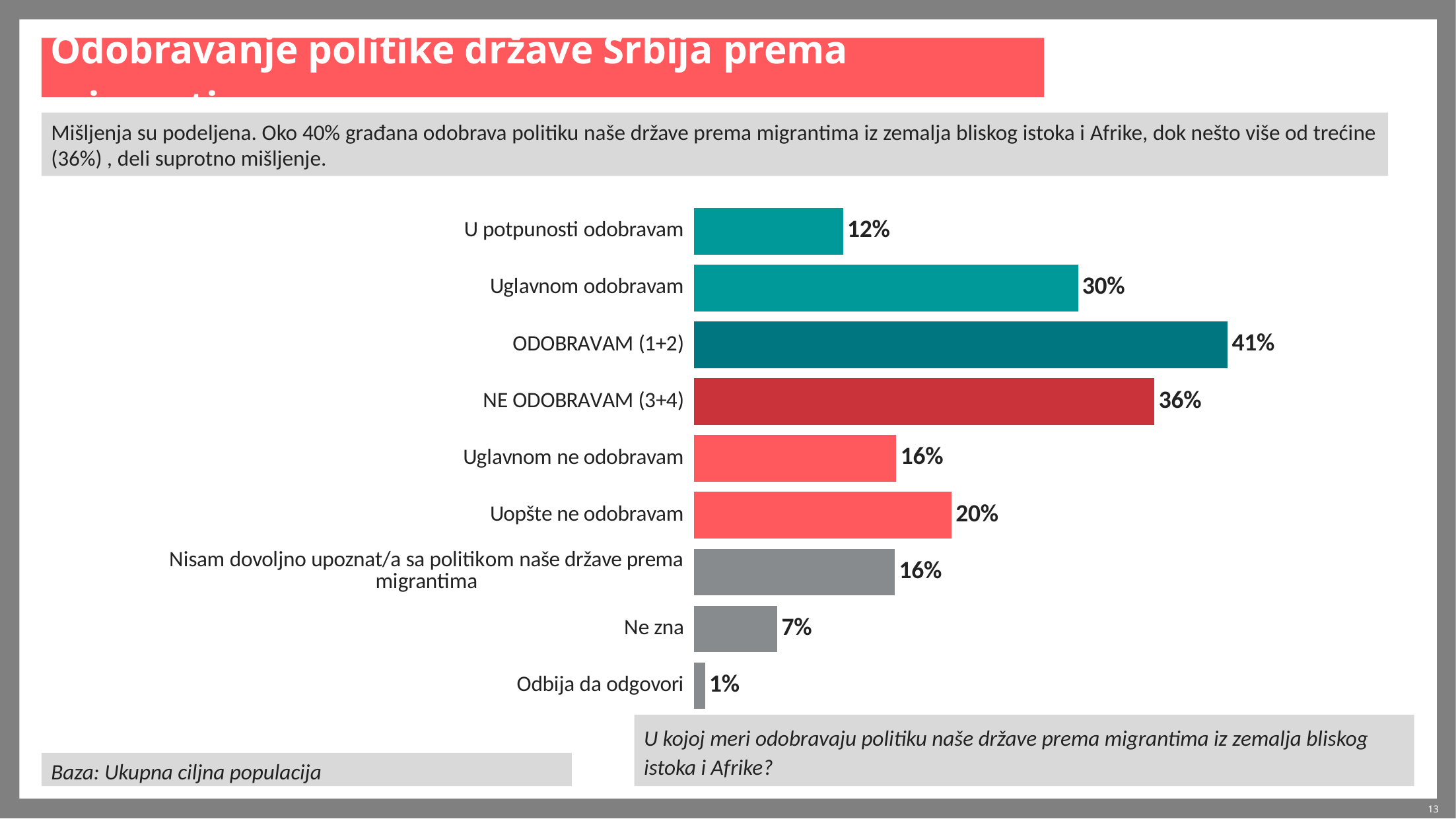
How many categories are shown in the chart? 9 Which category has the lowest value? Odbija da odgovori Which category has the highest value? ODOBRAVAM (1+2) What is the value for "Ne zna"? 7% What is the difference between "ODOBRAVAM (1+2)" and "NE ODOBRAVAM (3+4)"? 5% Which is larger, "Uglavnom odobravam" or "Uopšte ne odobravam"? Uglavnom odobravam What colour is the bar for "NE ODOBRAVAM (3+4)"? Dark red What is the value for "Uglavnom odobravam"? 30% What kind of chart is shown on the slide? Bar chart What is the value for "Nisam dovoljno upoznat/a sa politikom naše države prema migrantima"? 16% What is the difference between "Uopšte ne odobravam" and "U potpunosti odobravam"? 8% What is the value for "NE ODOBRAVAM (3+4)"? 36%